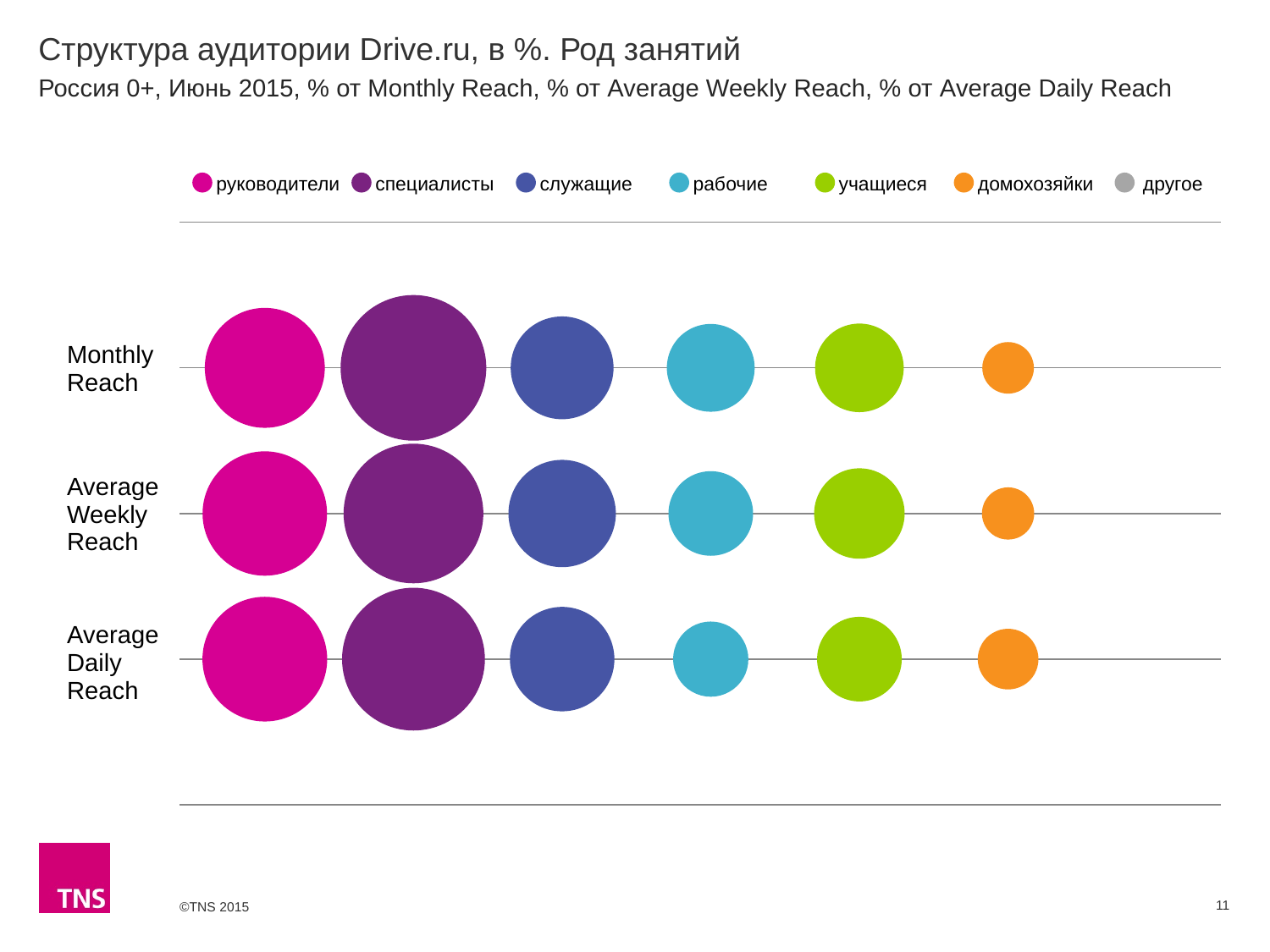
In the Average Weekly Reach row, which bubble is larger: домохозяйки or учащиеся? учащиеся Which occupation group has the smallest visible bubble in the Average Daily Reach row? домохозяйки Which occupation group has the largest bubble in the Average Weekly Reach row? специалисты Which colour represents руководители in the legend? magenta (pink) Which occupation group has the largest bubble in the Monthly Reach row? специалисты In the Average Daily Reach row, which bubble is larger: специалисты or рабочие? специалисты What kind of chart is shown on the slide? bubble chart In the Monthly Reach row, which bubble is larger: руководители or служащие? руководители How many series does the legend list? 7 What is the title of the chart on the slide? Структура аудитории Drive.ru, в %. Род занятий What are the three row labels on the chart? Monthly Reach, Average Weekly Reach, Average Daily Reach How many reach categories (rows) are plotted on the chart? 3